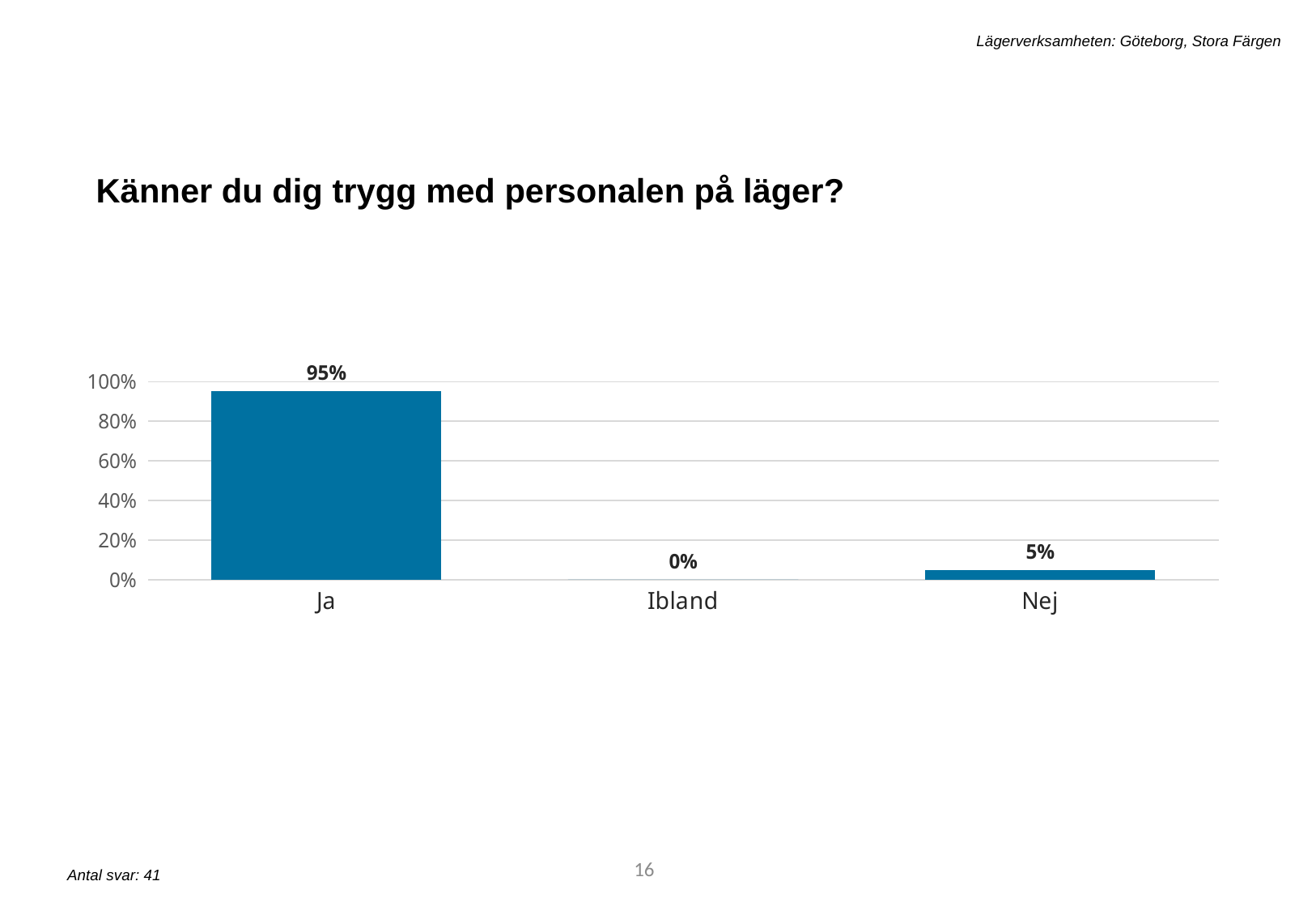
Which is larger, the value for Nej or the value for Ibland? Nej Which category has the lowest value? Ibland What is the value for Nej? 5% What is the title of the chart? Känner du dig trygg med personalen på läger? What is the value for Ja? 95% How many categories are shown on the x axis? 3 What is the value for Ibland? 0% What kind of chart is shown on the slide? bar chart Is the value for Nej greater or less than 20%? less Which category has the highest value? Ja Is the value for Ja greater or less than 80%? greater What is the difference between the values for Ja and Nej? 90%